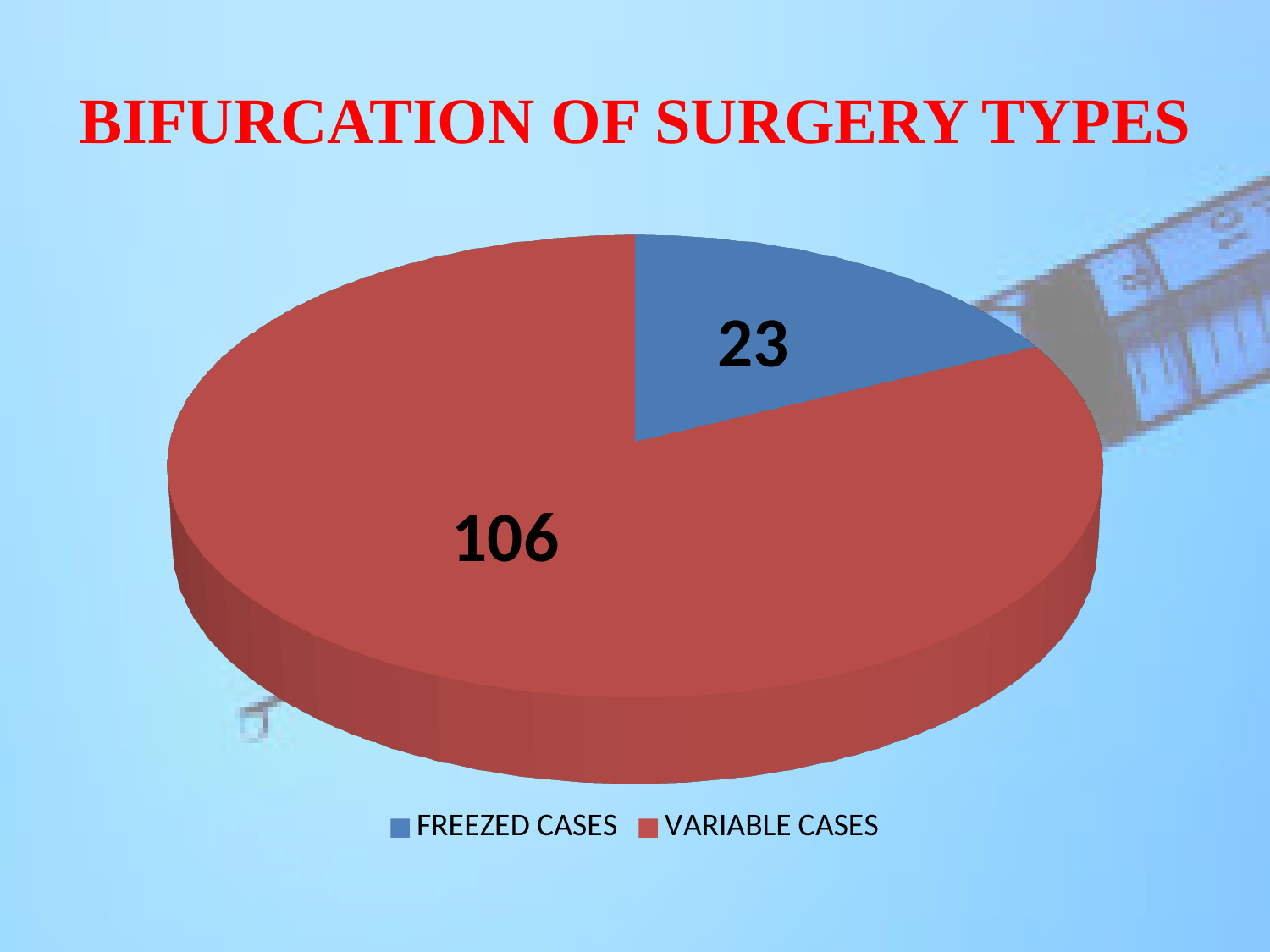
What is the value for VARIABLE CASES? 106 What colour is the FREEZED CASES slice? Blue What kind of chart is shown on the slide? Pie chart What is the value for FREEZED CASES? 23 Which category has the largest slice of the pie? VARIABLE CASES How many categories does the pie chart show? 2 What is the title of the slide? BIFURCATION OF SURGERY TYPES What is the total of all slices in the pie chart? 129 Which category has the smallest slice of the pie? FREEZED CASES Which is larger, FREEZED CASES or VARIABLE CASES? VARIABLE CASES What is the difference between VARIABLE CASES and FREEZED CASES? 83